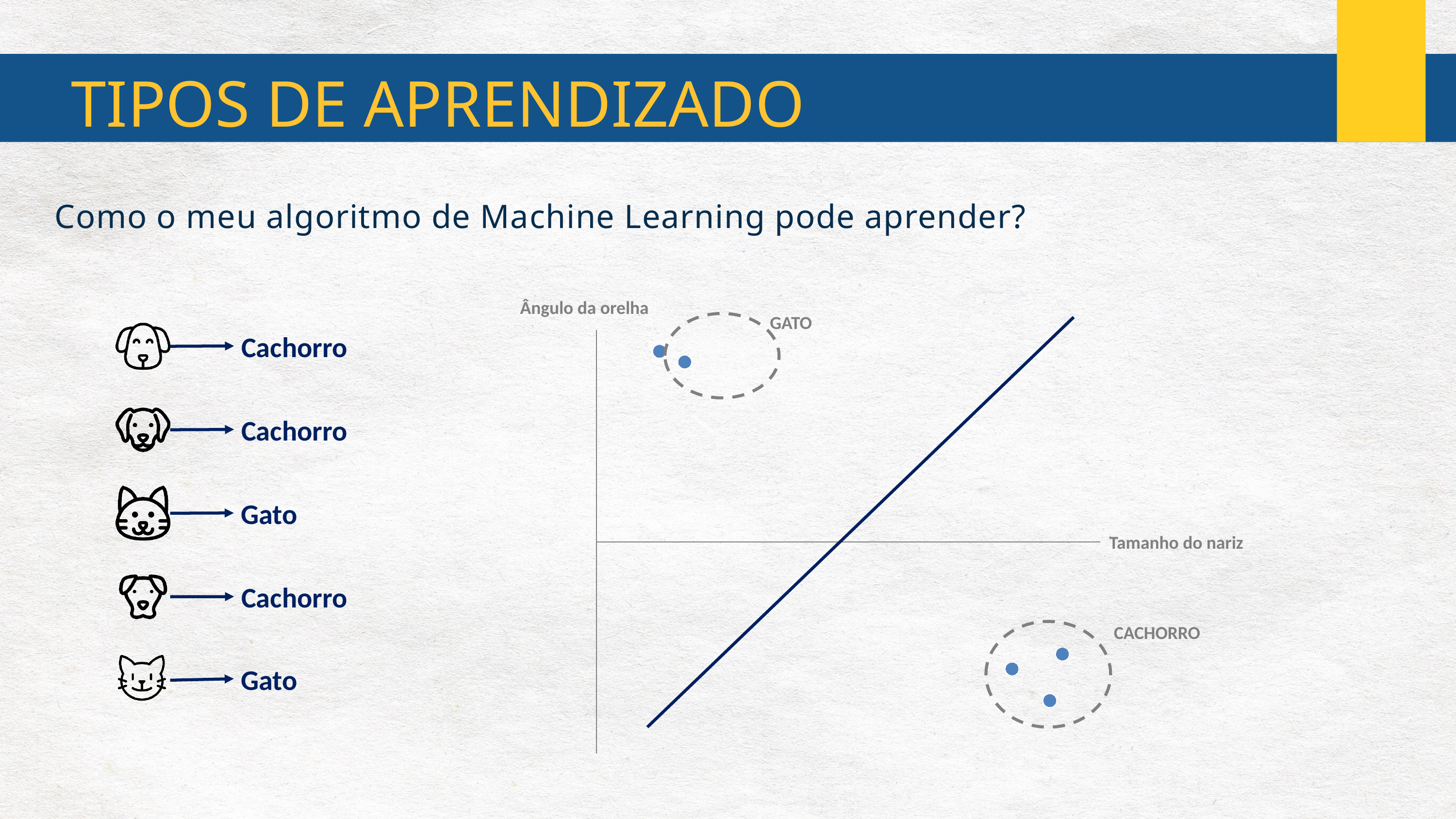
Which cluster has the larger values on the horizontal axis, GATO or CACHORRO? CACHORRO Does the dark diagonal line in the chart rise or fall from left to right? Rise How many data points are inside the cluster labelled CACHORRO? 3 Which cluster has the higher values on the vertical axis, GATO or CACHORRO? GATO What kind of chart is shown on the slide? Scatter plot What is the label of the vertical axis of the chart? Ângulo da orelha What is the label of the horizontal axis of the chart? Tamanho do nariz Which cluster contains more data points, GATO or CACHORRO? CACHORRO How many data points are plotted in the chart in total? 5 How many labelled clusters are circled in the chart? 2